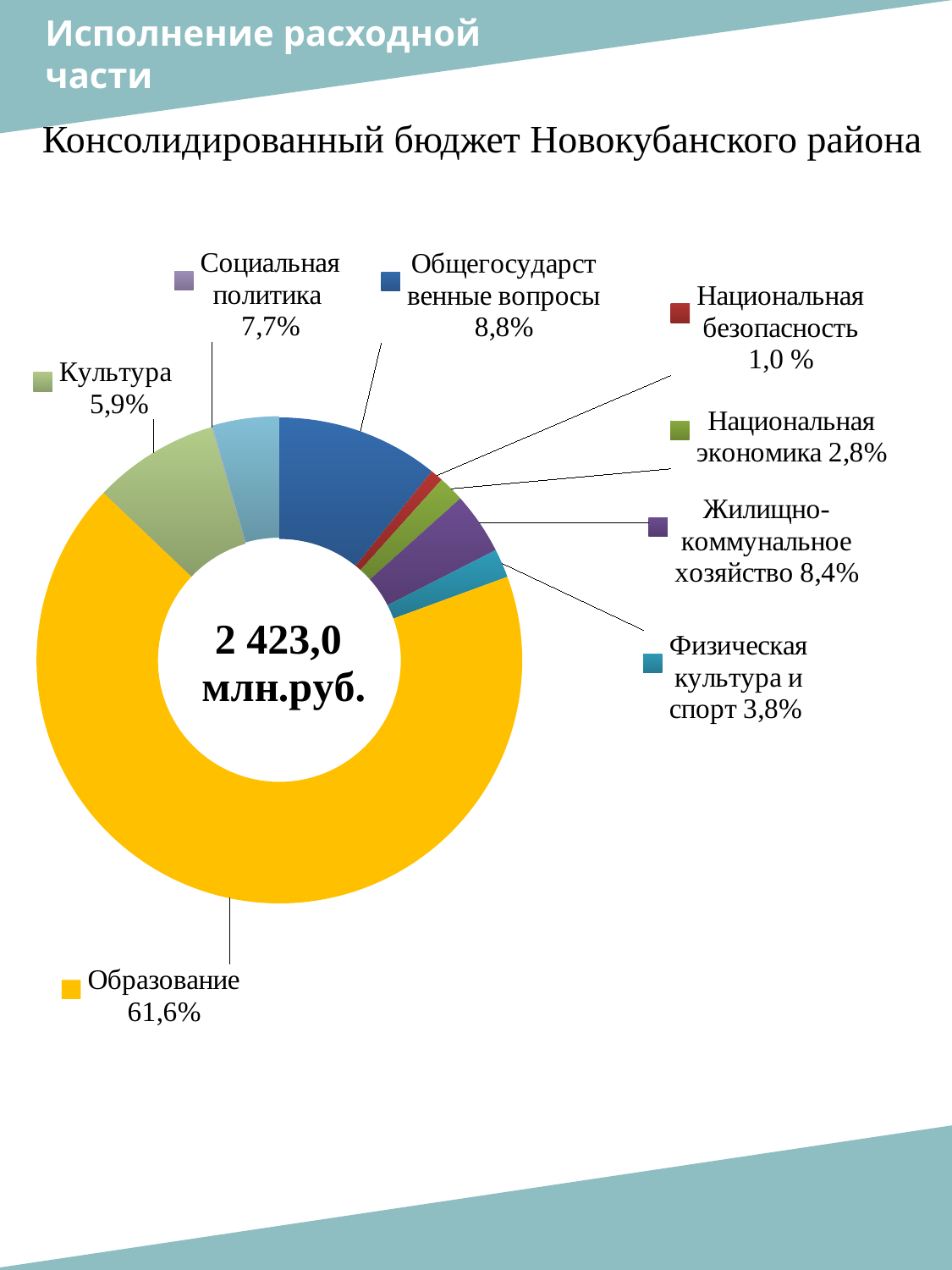
What is the title of the chart? Консолидированный бюджет Новокубанского района Which category has the largest share of the chart? Образование What total amount is printed in the centre of the chart? 2 423,0 млн.руб. What kind of chart is shown on the slide? Pie (doughnut) chart Which category has the smallest share of the chart? Национальная безопасность What is the value shown for Жилищно-коммунальное хозяйство? 8,4% What is the value shown for Общегосударственные вопросы? 8,8% What is the difference between the shares of Общегосударственные вопросы and Физическая культура и спорт? 5,0% What share of the chart does Образование account for? 61,6% What is the value shown for Национальная безопасность? 1,0 % Which is larger: Социальная политика or Культура? Социальная политика How many categories are shown in the chart? 8